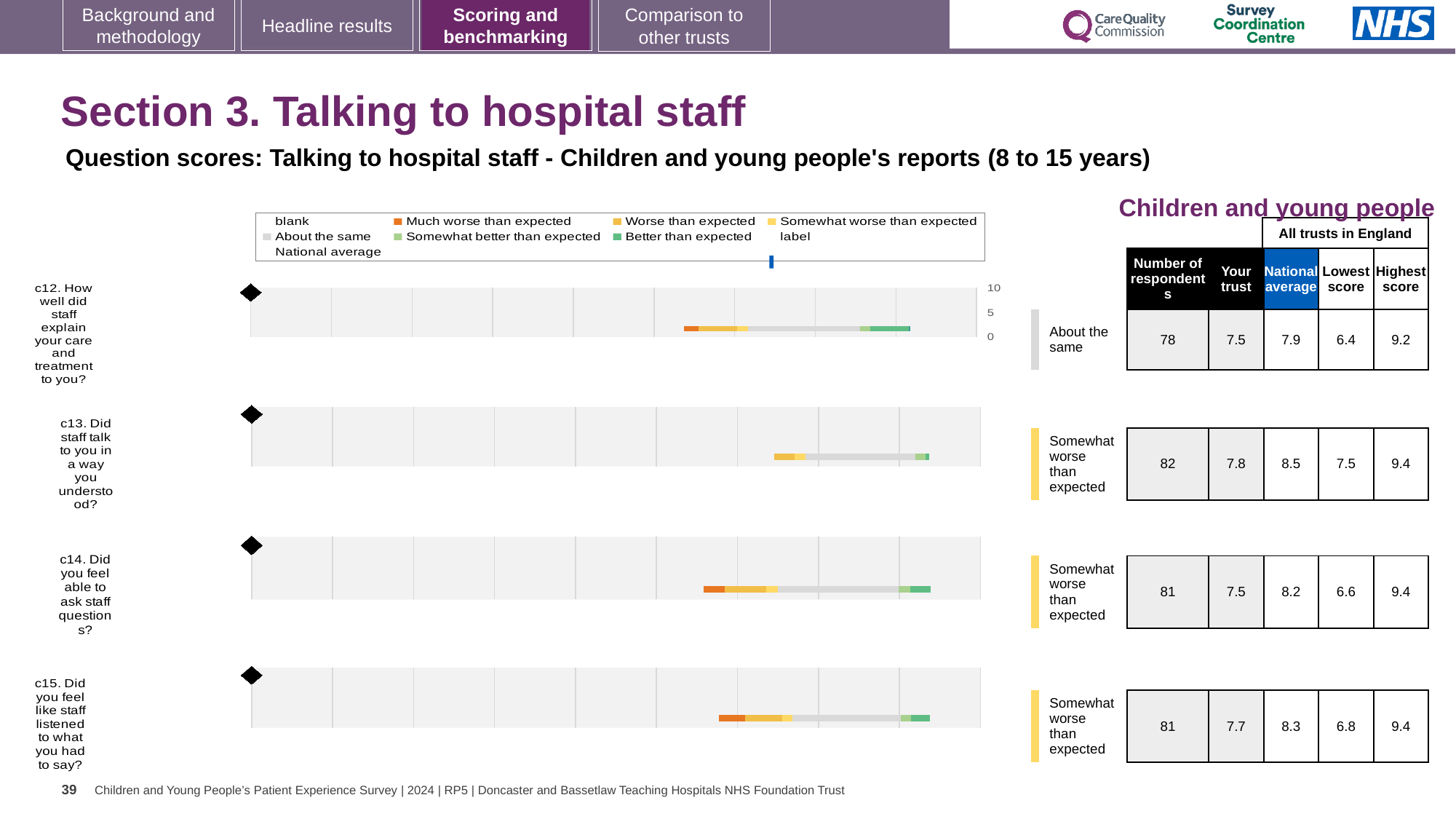
For c14 (Did you feel able to ask staff questions?), what is the difference between the national average and the 'Your trust' score? 0.7 For c15 (Did you feel like staff listened to what you had to say?), is the 'Your trust' score higher or lower than the national average? lower How many question charts (c12 to c15) are shown on the slide? 4 Which question has the highest 'Your trust' score? c13 For c12, how many respondents are there? 78 For c12 (How well did staff explain your care and treatment to you?), what is the 'Your trust' score? 7.5 What kind of chart is used for each question (c12 to c15)? bar chart Which question has the lowest national average score? c12 In the legend, which colour represents 'Much worse than expected'? orange Which benchmark category is c12 rated as? About the same For c13 (Did staff talk to you in a way you understood?), what is the national average score? 8.5 For c13, what is the highest score among all trusts in England? 9.4